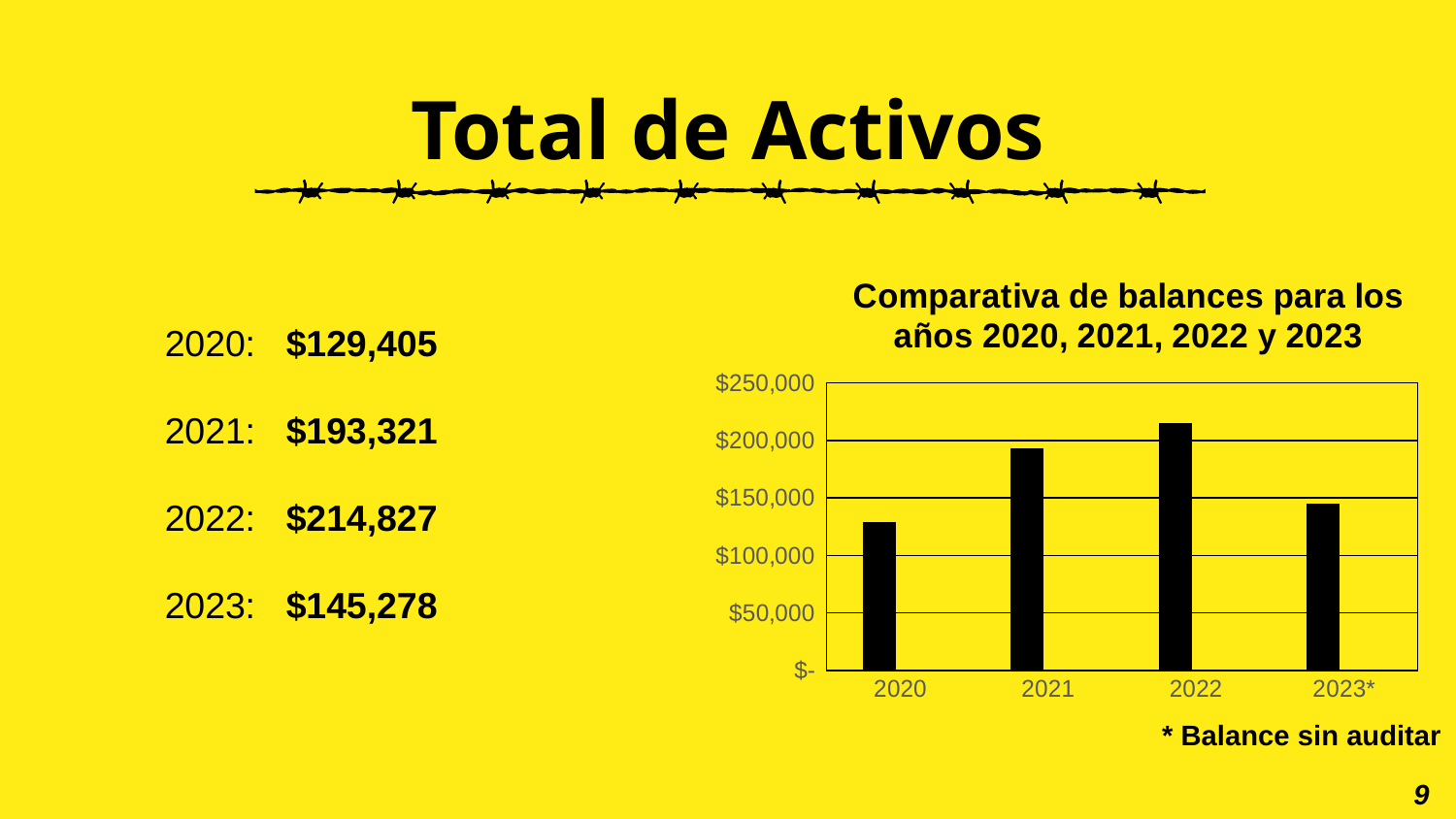
What type of chart is shown on the slide? Bar chart What is the value shown for 2022? $214,827 What is the difference between the values for 2022 and 2021? $21,506 Is the value for 2021 greater or less than $150,000? greater What does the asterisk next to 2023 on the chart indicate, according to the footnote? Balance sin auditar How many bars (years) does the chart show? 4 Which year has the lowest value in the chart? 2020 Is the value for 2023 greater or less than $150,000? less Which year has the highest value in the chart? 2022 Which is larger, the value for 2021 or the value for 2023? 2021 What is the value shown for 2020? $129,405 What is the value shown for 2023? $145,278